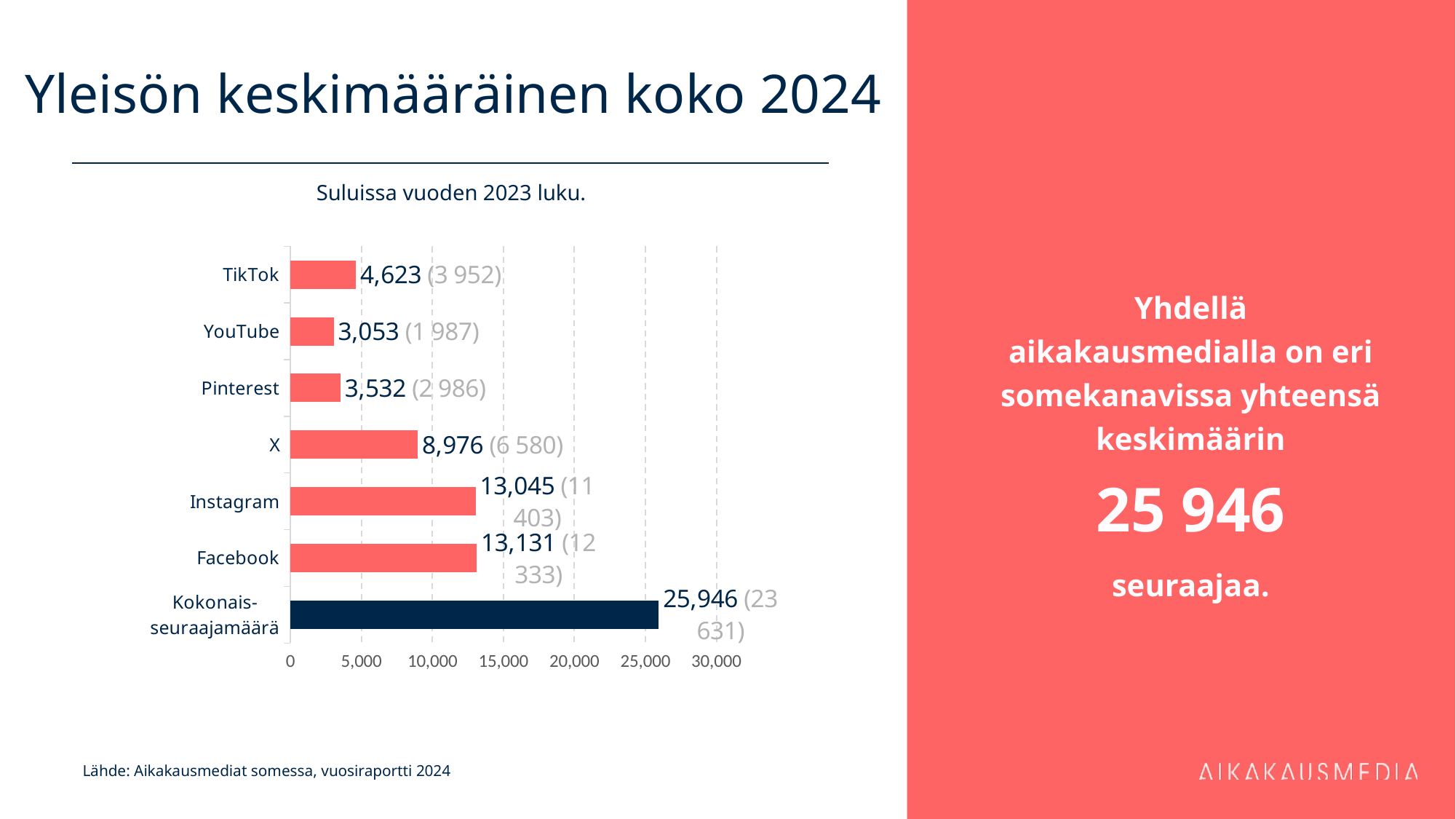
Which category has the highest value in the chart? Kokonais-seuraajamäärä What kind of chart is shown on the slide? bar chart What is the 2023 value shown in parentheses for YouTube? 1 987 What is the 2024 value for Kokonais-seuraajamäärä? 25,946 What is the difference between the 2024 values for TikTok and YouTube? 1,570 What is the 2023 value shown in parentheses for Instagram? 11 403 What is the difference between the 2024 values for Facebook and Instagram? 86 Which category has the lowest 2024 value in the chart? YouTube Is the value for X greater or less than 10,000? less What is the 2024 value for X? 8,976 What is the 2024 value for TikTok? 4,623 How many categories are shown in the chart? 7